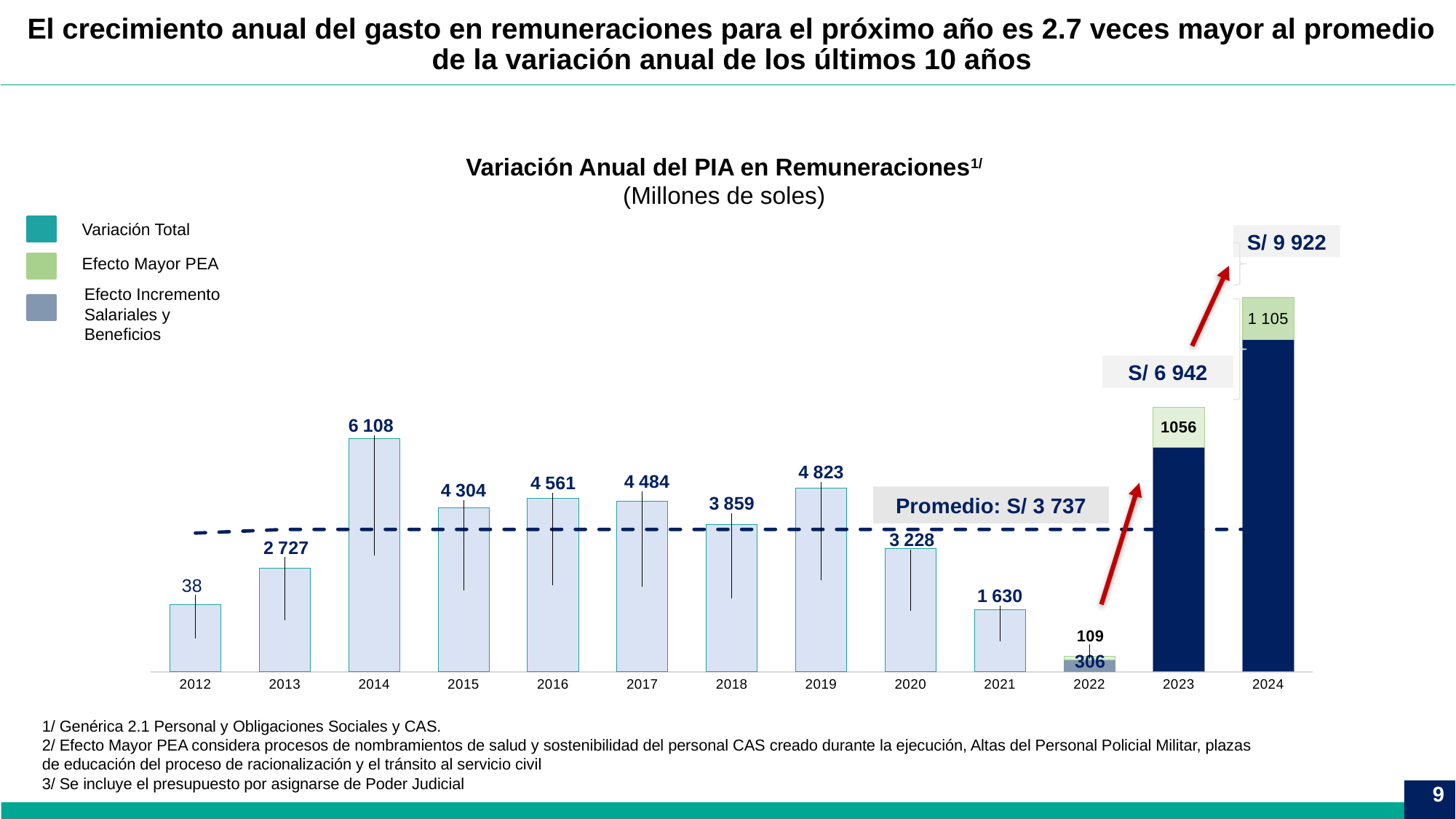
Which year has the highest total value in the chart? 2024 What is the value of the Variación Total bar for 2014? 6 108 What is the Efecto Mayor PEA value for 2023? 1056 What is the difference between the values for 2014 and 2013? 3 381 What total value is shown for 2024? S/ 9 922 How many series does the legend list? 3 Which year has a larger value, 2016 or 2017? 2016 What is the average (Promedio) value indicated by the dashed line? S/ 3 737 What is the difference between the totals for 2024 and 2023? 2 980 How many years are shown on the x axis? 13 What is the value shown for 2012? 38